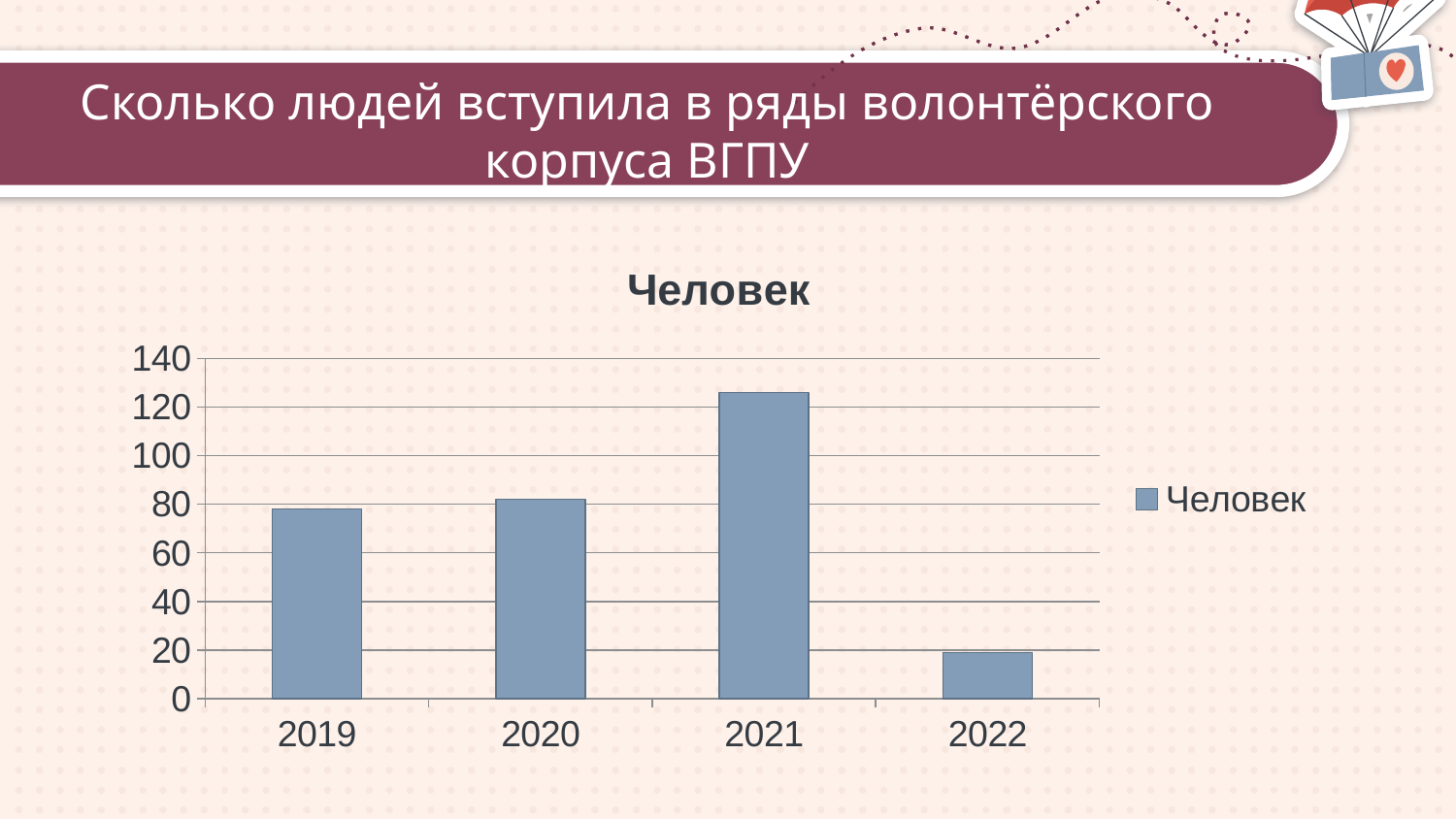
How many series does the legend list? 1 Which is larger, the value for 2021 or the value for 2019? 2021 How many years are shown on the x axis of the chart? 4 What kind of chart is shown on the slide? bar chart Is the value for 2022 greater or less than 40? less What is the title of the chart? Человек Which year has the highest value in the chart? 2021 Is the value for 2021 greater or less than 120? greater Which year has the lowest value in the chart? 2022 Does the value rise or fall from 2021 to 2022? fall Is the value for 2019 greater or less than 100? less